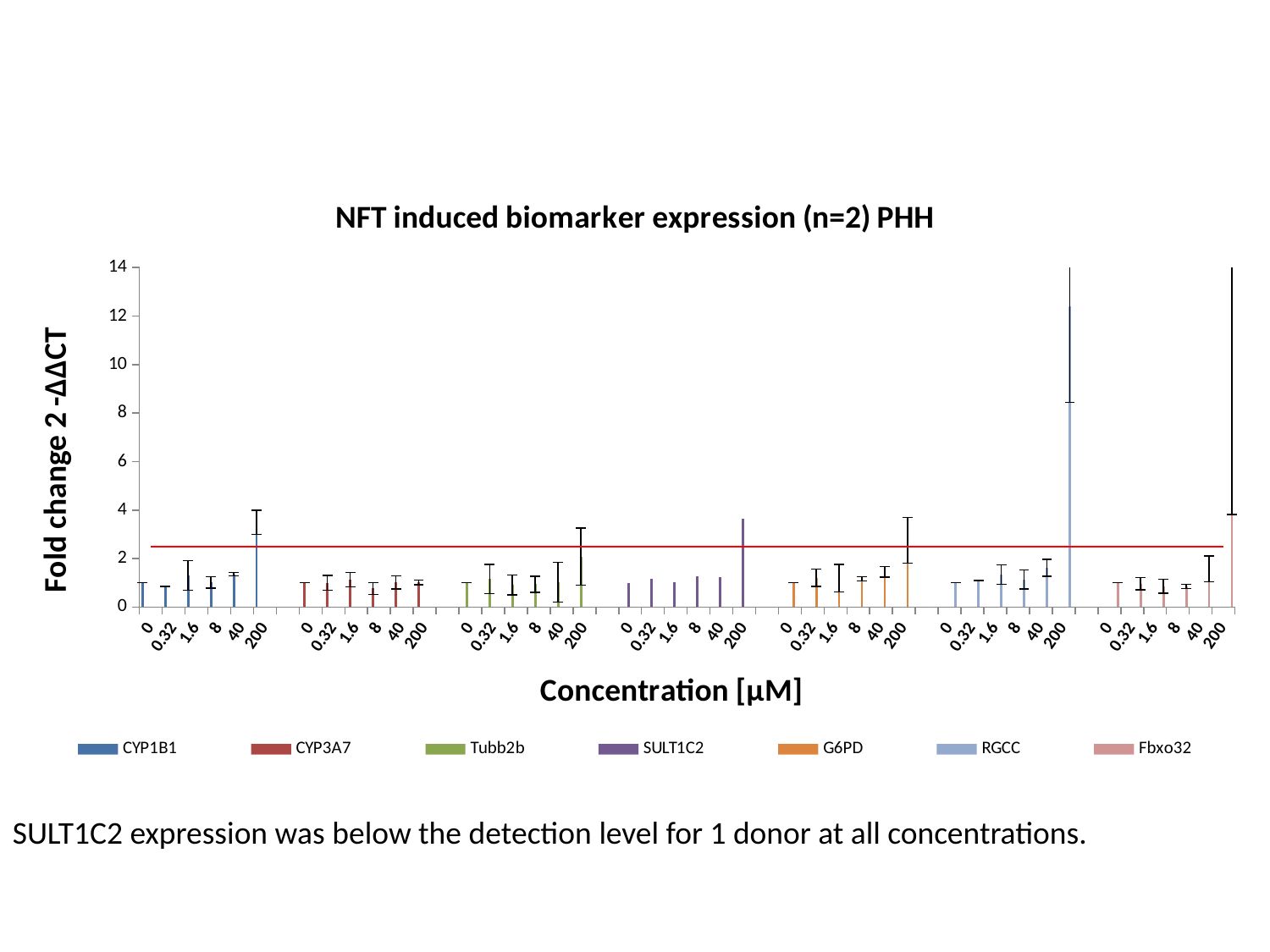
Is the value for SULT1C2 at 200 µM greater or less than 2? greater Is the value for CYP1B1 at 200 µM greater or less than 2? greater Which is larger: the value for RGCC at 200 µM or the value for CYP1B1 at 200 µM? RGCC at 200 µM What is the title of the chart? NFT induced biomarker expression (n=2) PHH Which series has the tallest bar in the chart? RGCC What kind of chart is shown on the slide? bar chart What is the label of the x axis? Concentration [µM] At which concentration does the RGCC series reach its highest value? 200 How many concentration levels are plotted for each series? 6 How many series does the legend list? 7 Is the value for CYP3A7 at 0 µM greater or less than 2? less